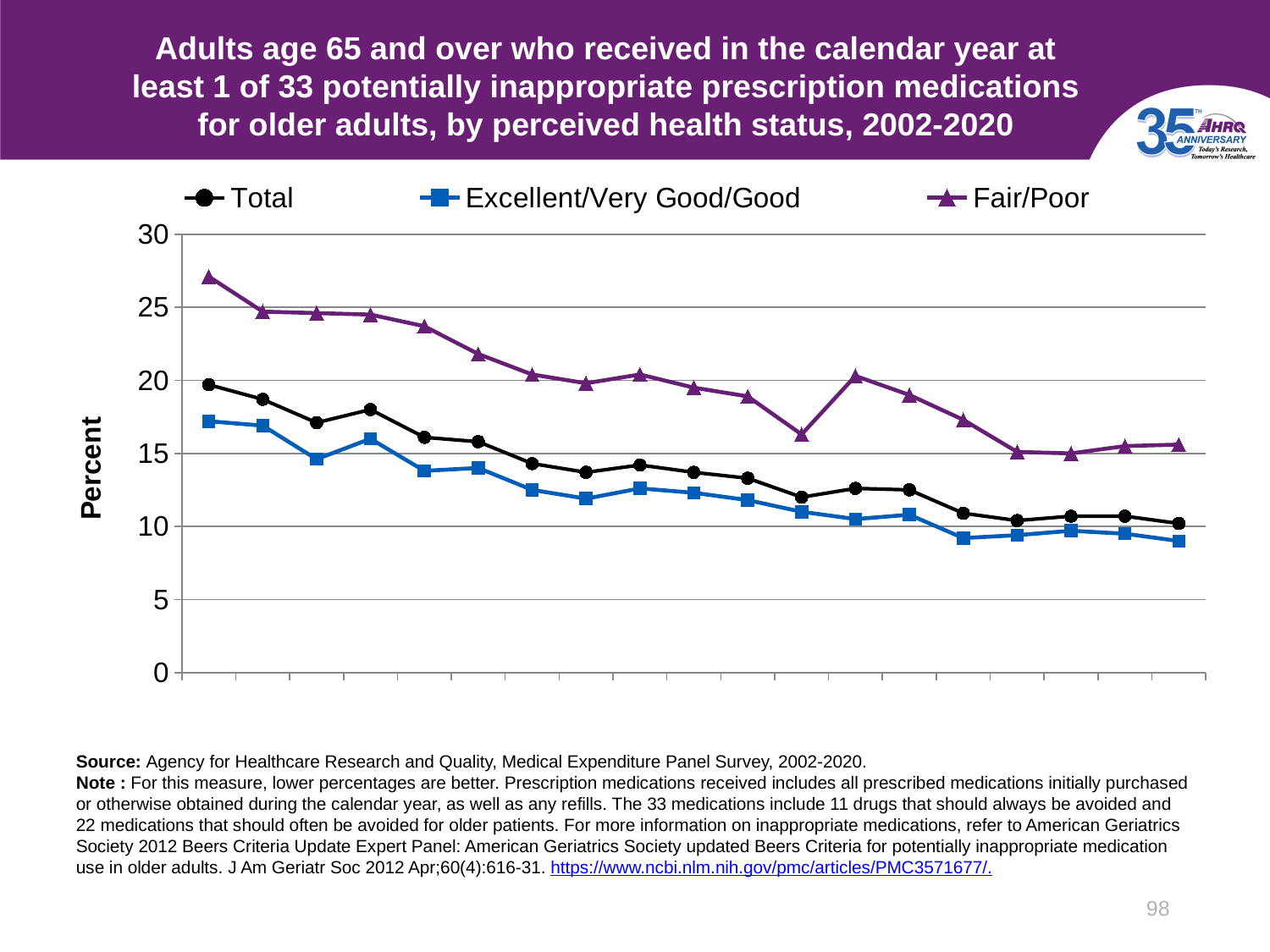
What kind of chart is shown on the slide? Line chart Is the last value for the Excellent/Very Good/Good series greater or less than 10? less How many series does the legend list? 3 Is the last value for the Fair/Poor series greater or less than 15? greater Is the first value for the Fair/Poor series greater or less than 25? greater Which series has the lowest values across the whole period? Excellent/Very Good/Good At the first point, which is larger: the Fair/Poor value or the Excellent/Very Good/Good value? Fair/Poor What is the label on the vertical axis? Percent Which series are listed in the legend? Total, Excellent/Very Good/Good, Fair/Poor Do the values for the Fair/Poor series generally rise or fall from left to right? Fall Do the values for the Total series generally rise or fall over the period? Fall Which series has the highest values across the whole period? Fair/Poor